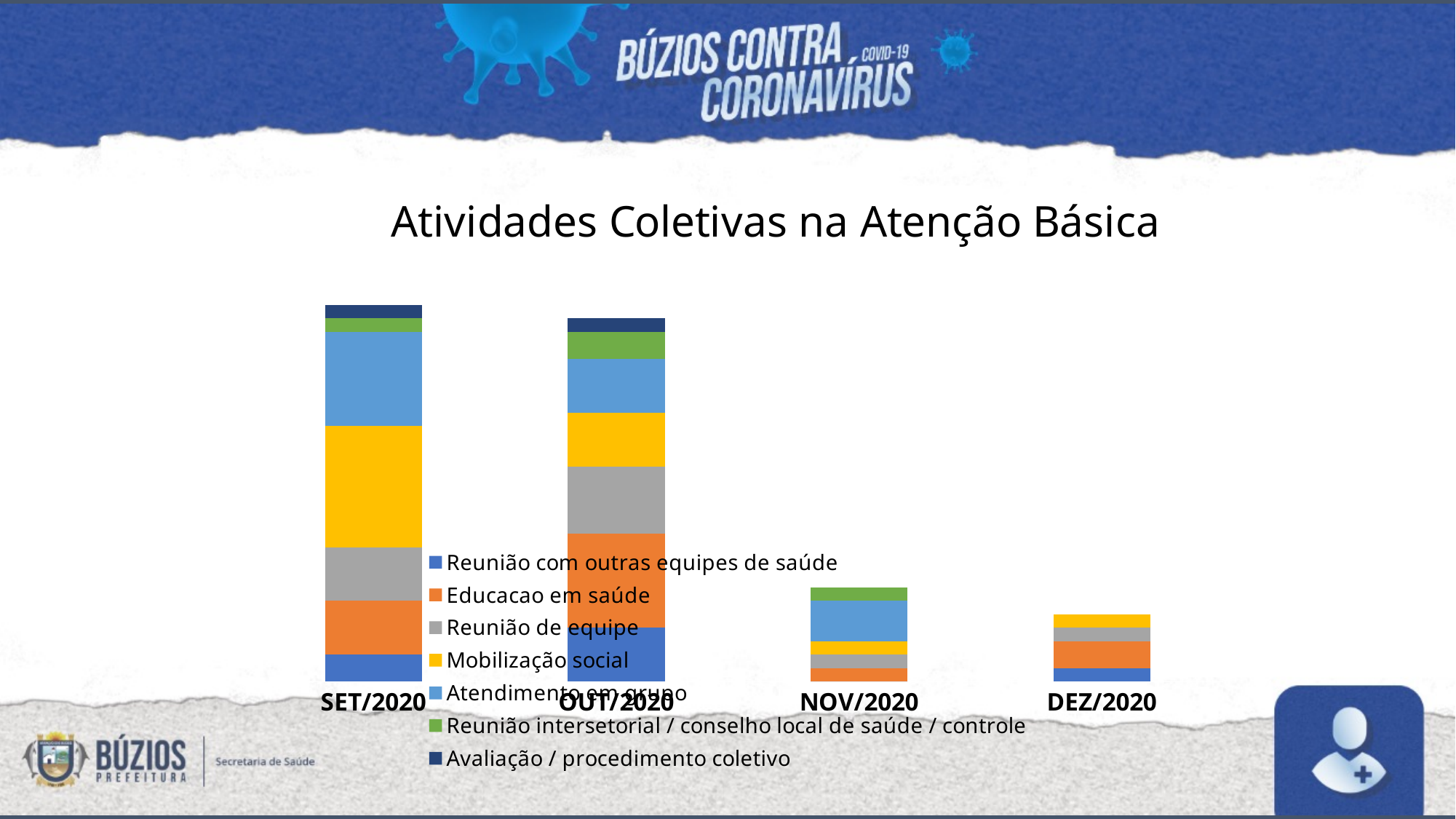
Which stacked bar is taller, SET/2020 or OUT/2020? SET/2020 Which series has the largest segment in the OUT/2020 bar? Educacao em saúde Which month has the shortest stacked bar? DEZ/2020 How many series does the legend list? 7 How many months (categories) are shown on the x axis? 4 Which stacked bar is taller, NOV/2020 or DEZ/2020? NOV/2020 Which colour represents Mobilização social in the legend? Yellow What kind of chart is shown on the slide? Stacked bar chart Which month has the tallest stacked bar? SET/2020 What is the title of the chart? Atividades Coletivas na Atenção Básica Which series has the largest segment in the SET/2020 bar? Mobilização social Do the total bar heights rise or fall from SET/2020 to DEZ/2020? Fall